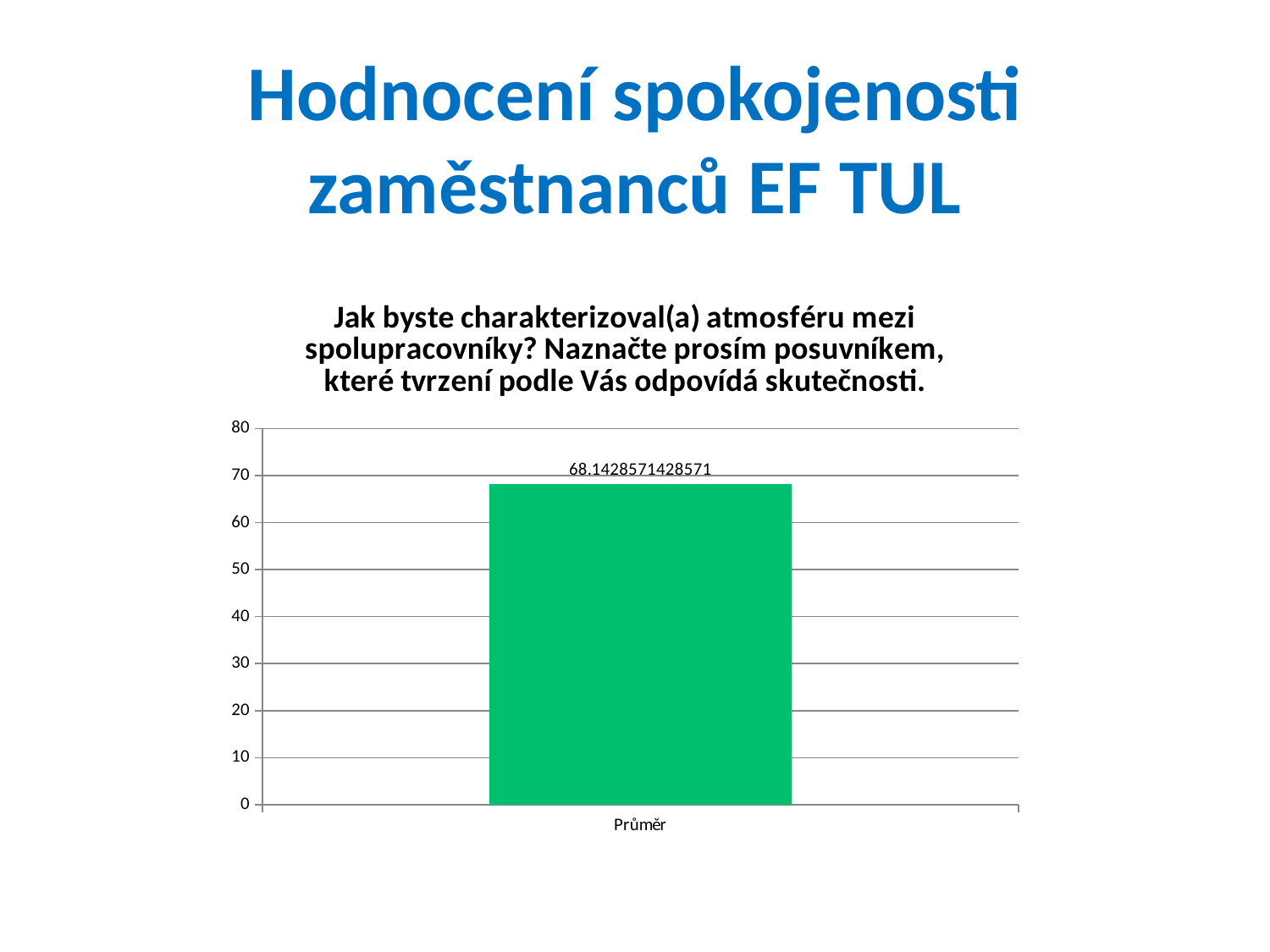
How many bars are plotted in the chart? 1 Is the value for Průměr greater or less than 70? less Is the value for Průměr greater or less than 60? greater What is the value shown for Průměr? 68.1428571428571 What is the maximum value shown on the vertical axis? 80 What is the label of the category on the x axis? Průměr What kind of chart is shown on the slide? bar chart